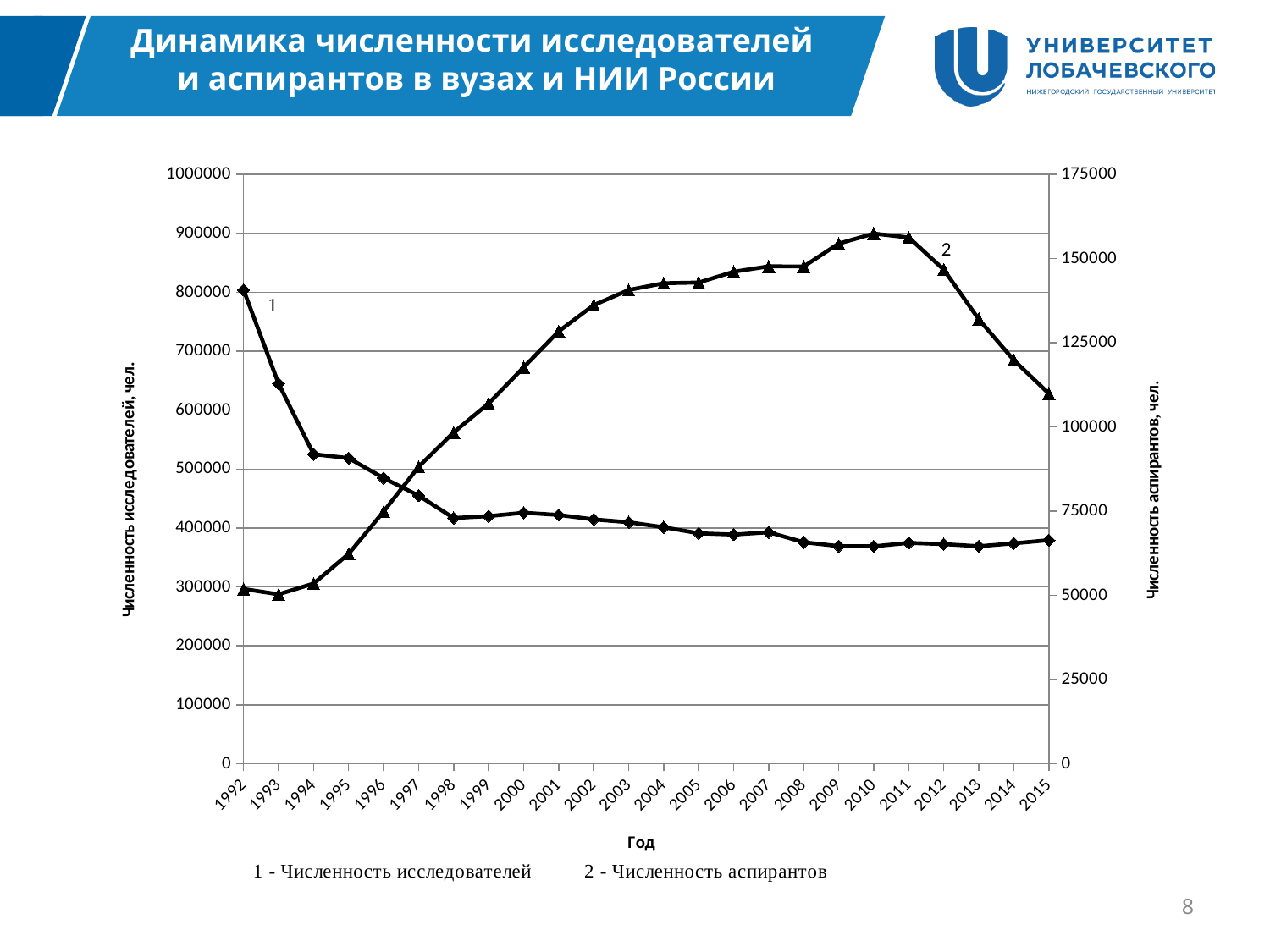
Is the value of series 1 (Численность исследователей) in 2015 greater or less than 400000? less What kind of chart is shown on the slide? Line chart In which year does series 2 (Численность аспирантов) reach its highest value? 2010 How many years are plotted along the x axis? 24 In which year is series 1 (Численность исследователей) at its highest? 1992 Does series 1 (Численность исследователей) rise or fall from 1992 to 2015? Fall How many series does the legend below the chart list? 2 Which is larger for series 2 (Численность аспирантов): the value in 1992 or the value in 2015? 2015 Does series 2 (Численность аспирантов) rise or fall from 1992 to 2010? Rise Is the value of series 2 (Численность аспирантов) in 2010 greater or less than 150000? greater What is the title of the x axis? Год Is the value of series 1 (Численность исследователей) in 1992 greater or less than 700000? greater